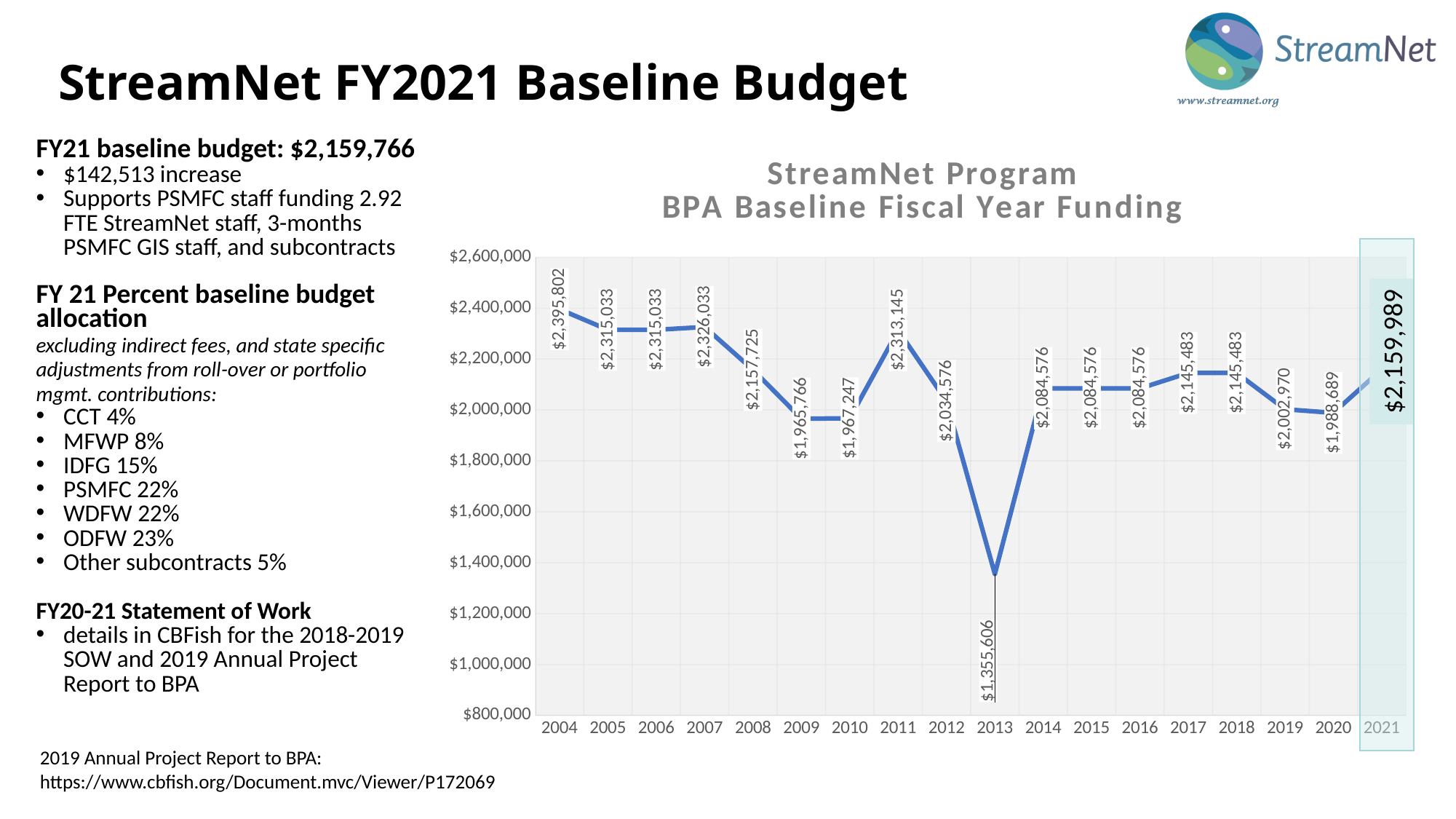
Which year has the larger funding value, 2011 or 2012? 2011 How many years are plotted on the chart? 18 What is the funding value for 2013? $1,355,606 What is the funding value for 2004? $2,395,802 What type of chart is shown on the slide? line chart Which year has the lowest funding value? 2013 What is the difference between the funding values for 2021 and 2020? $171,300 Does the funding value rise or fall from 2004 to 2009? fall What is the title of the chart? StreamNet Program BPA Baseline Fiscal Year Funding What is the difference between the funding values for 2004 and 2013? $1,040,196 Which year has the highest funding value? 2004 What is the funding value for 2021? $2,159,989